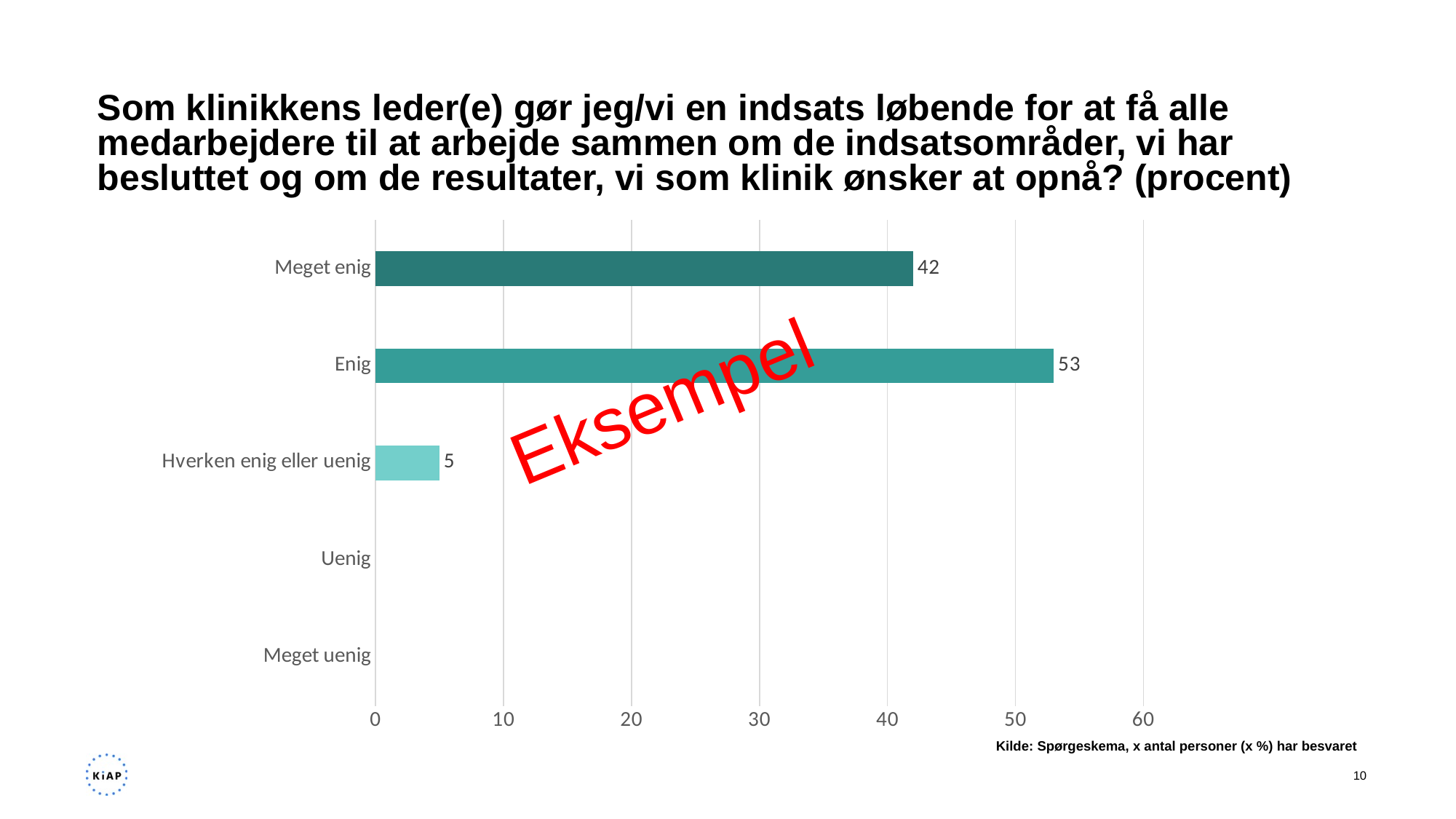
Which category with a visible bar has the lowest value? Hverken enig eller uenig What is the value for "Hverken enig eller uenig"? 5 What is the value for "Meget enig"? 42 What is the value for "Enig"? 53 How many categories are listed on the vertical axis? 5 What is the highest tick value shown on the horizontal axis? 60 Which category has the highest value? Enig What kind of chart is shown on the slide? Bar chart What red word is stamped across the chart? Eksempel Is the value for "Enig" greater or less than 50? greater Which is larger, the value for "Meget enig" or the value for "Hverken enig eller uenig"? Meget enig What is the difference between the values for "Enig" and "Meget enig"? 11